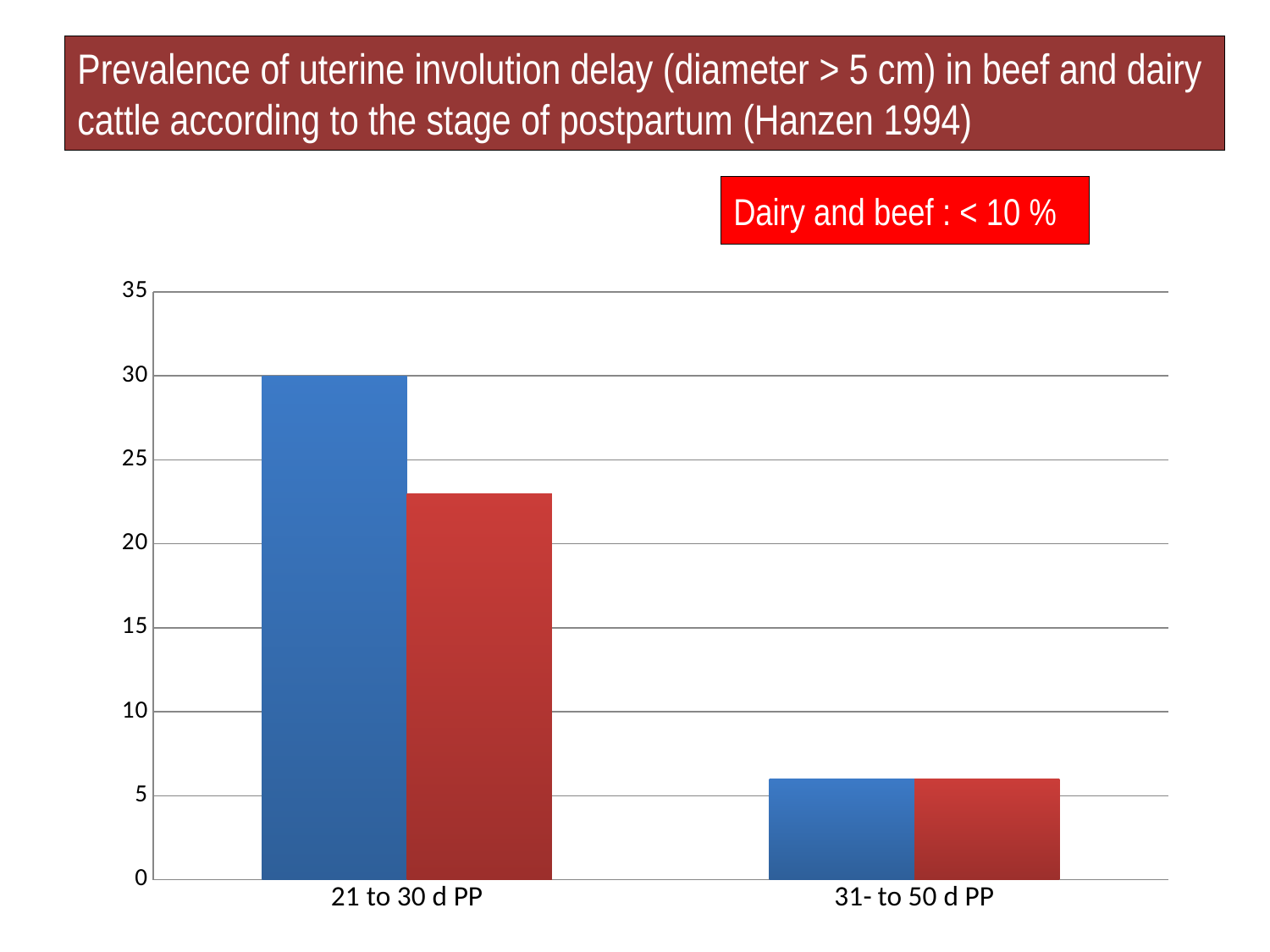
Which category has the lowest value for the red bars? 31- to 50 d PP Is the value of the blue bar for 31- to 50 d PP greater or less than 10? less Is the value of the red bar for 21 to 30 d PP greater or less than 25? less Is the value of the red bar for 31- to 50 d PP greater or less than 5? greater Which category has the highest value for the blue bars? 21 to 30 d PP Do the values rise or fall from 21 to 30 d PP to 31- to 50 d PP? fall What is the value of the blue bar for the category 21 to 30 d PP? 30 What kind of chart is shown on the slide? bar chart For the category 21 to 30 d PP, which bar is taller, the blue one or the red one? the blue one What is the highest value shown on the vertical axis of the chart? 35 How many categories are shown on the x axis of the chart? 2